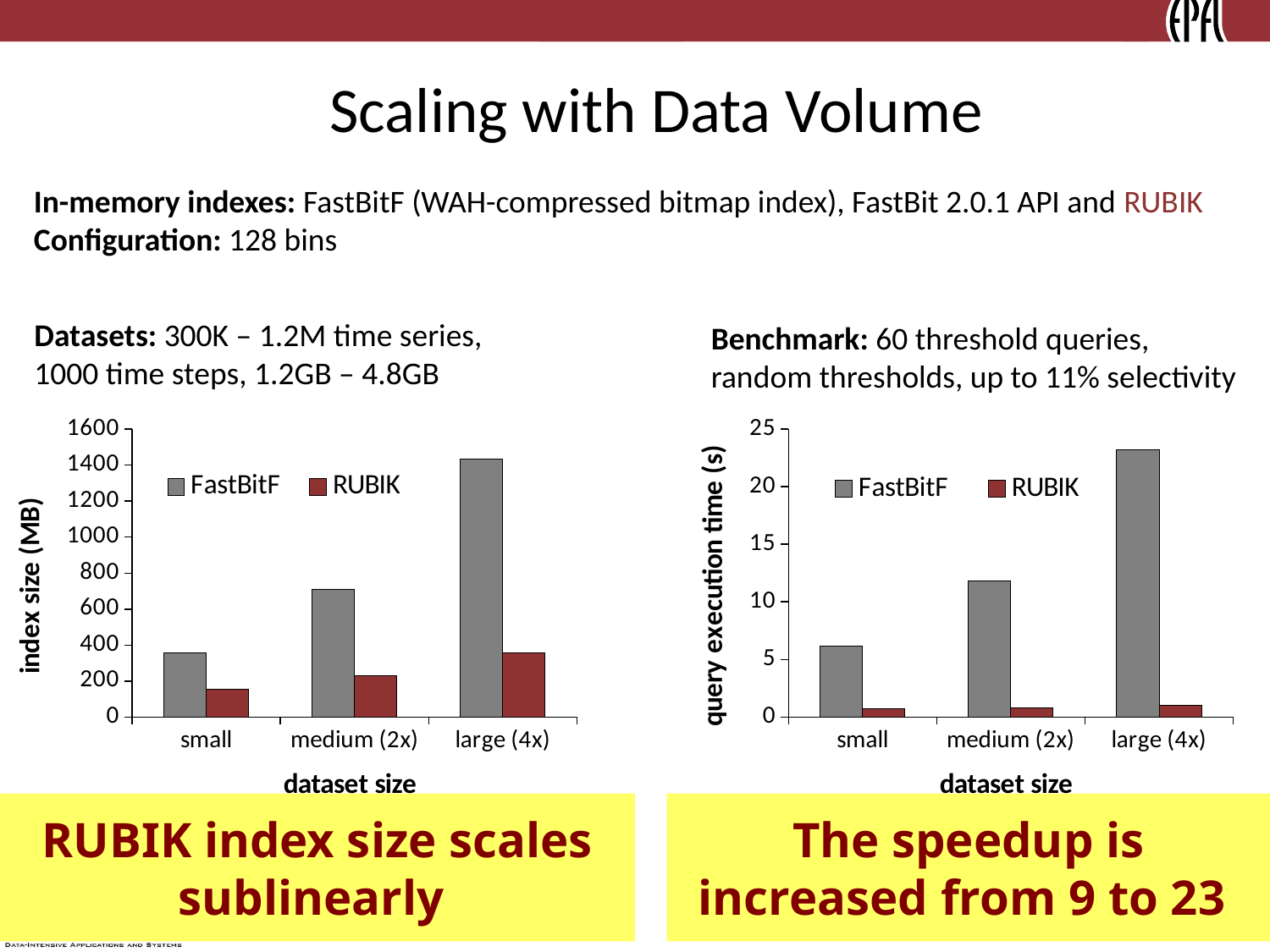
How many series does the legend of the right chart (query execution time) list? 2 In the left chart (index size), which dataset size has the highest FastBitF index size? large (4x) In the right chart (query execution time), which is larger for large (4x): FastBitF or RUBIK? FastBitF In the left chart (index size), is the FastBitF index size for large (4x) greater or less than 1400? greater In the left chart (index size), do the FastBitF index sizes rise or fall as the dataset size increases from small to large (4x)? rise How many dataset size categories are shown on the x axis of the left chart (index size)? 3 In the right chart (query execution time), is the FastBitF query execution time for medium (2x) greater or less than 10? greater What is the y-axis title of the right chart? query execution time (s) What kind of chart is the left chart (index size)? bar chart In the left chart (index size), is the RUBIK index size for medium (2x) greater or less than 400? less In the right chart (query execution time), which dataset size has the lowest FastBitF query execution time? small